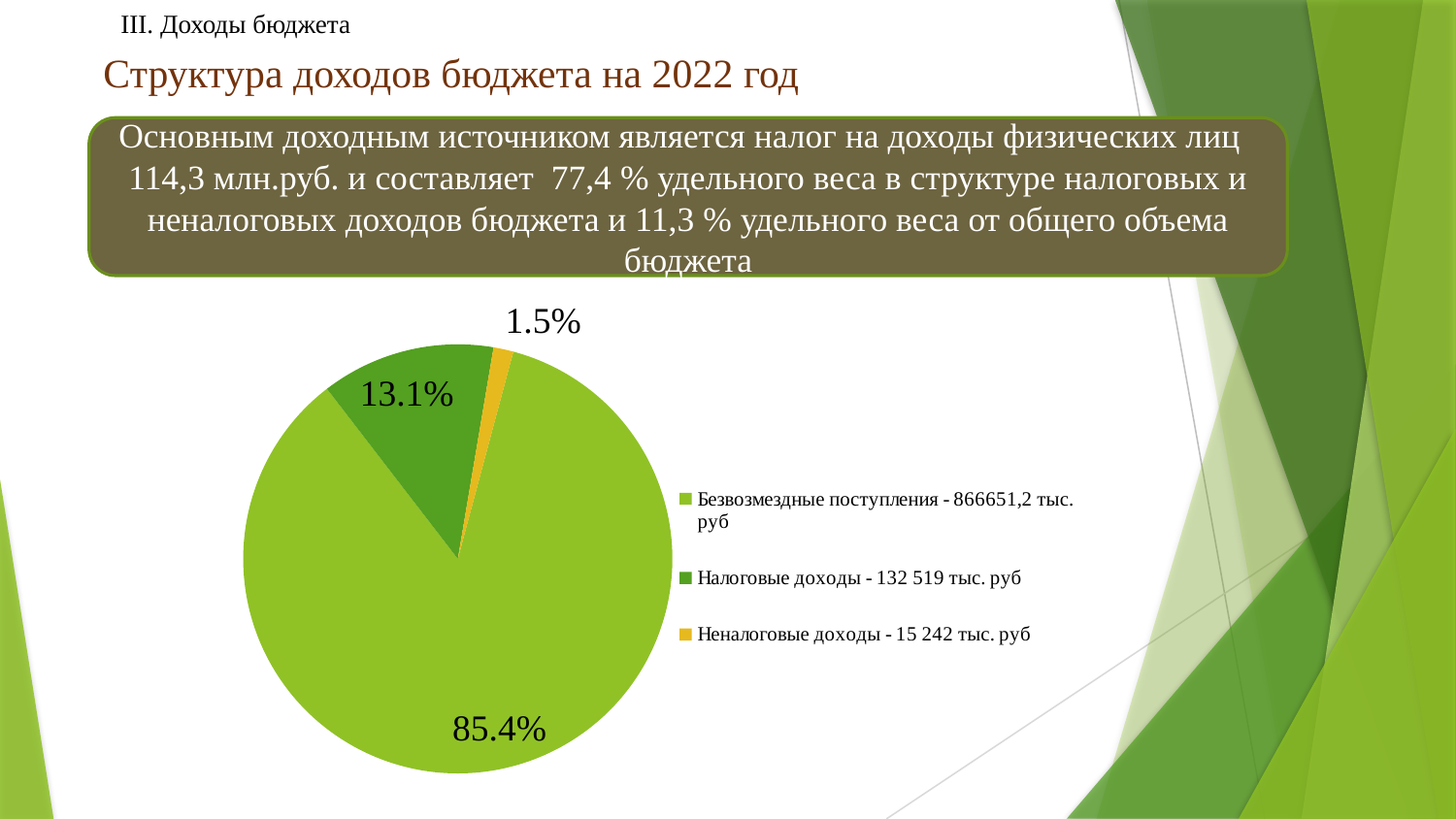
What is the difference in percentage points between the Налоговые доходы slice and the Неналоговые доходы slice? 11.6 Which slice is larger: Налоговые доходы or Неналоговые доходы? Налоговые доходы According to the legend, what amount is given for Налоговые доходы? 132 519 тыс. руб Which category has the smallest slice of the pie? Неналоговые доходы What share of the pie does Безвозмездные поступления take? 85.4% How many slices does the pie chart have? 3 What share of the pie does Неналоговые доходы take? 1.5% How many entries does the legend list? 3 Which category has the largest slice of the pie? Безвозмездные поступления What is the difference in percentage points between the Безвозмездные поступления slice and the Налоговые доходы slice? 72.3 What kind of chart is shown on the slide? pie chart What share of the pie does Налоговые доходы take? 13.1%